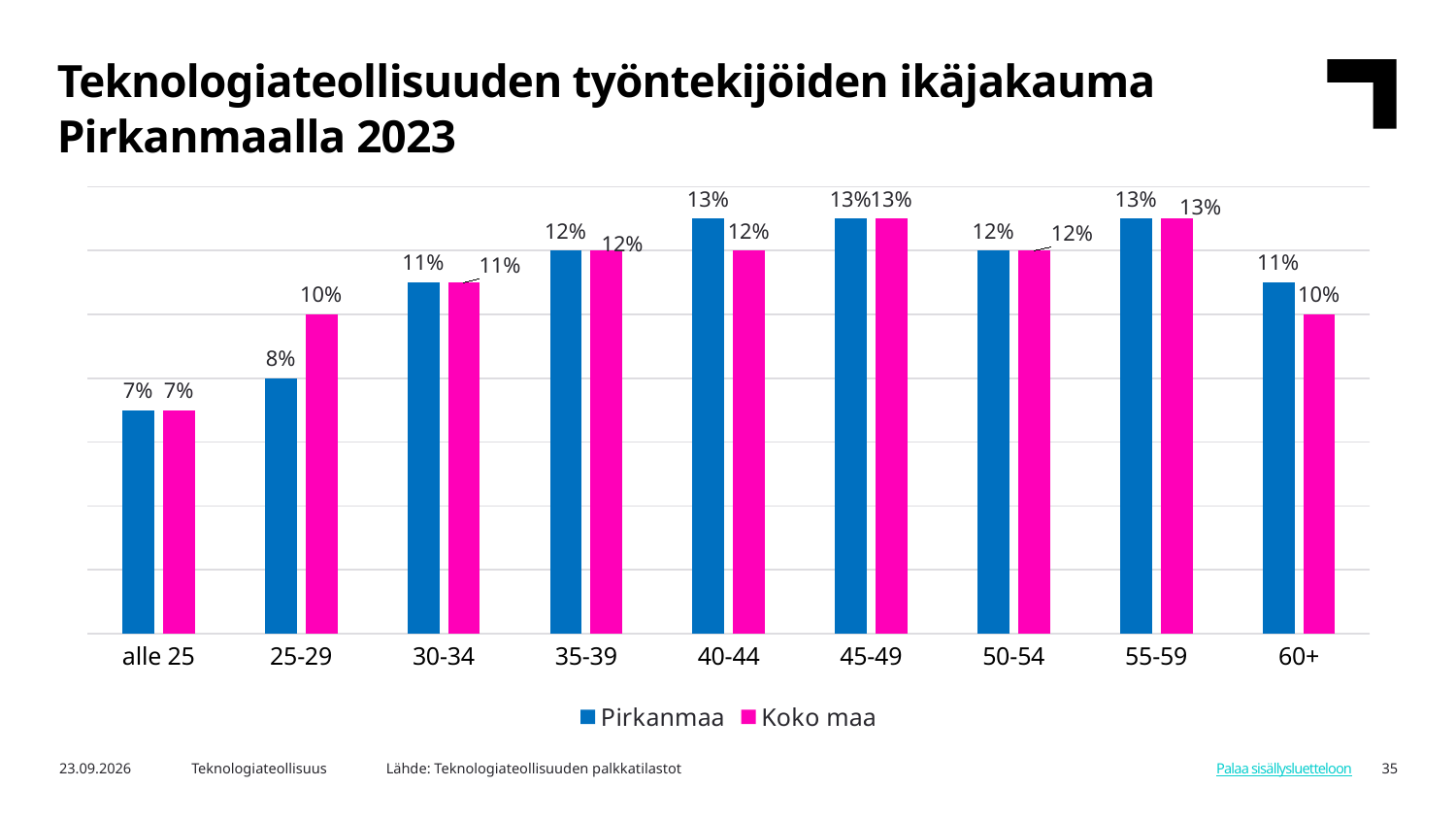
In the 60+ age group, which series has the larger value, Pirkanmaa or Koko maa? Pirkanmaa Which age group has the lowest value for Koko maa? alle 25 How many age groups are shown on the x axis? 9 How many series does the legend list? 2 What is the value for Koko maa in the 25-29 age group? 10% What is the value for Koko maa in the 40-44 age group? 12% What is the value for Pirkanmaa in the 60+ age group? 11% What is the value for Pirkanmaa in the 25-29 age group? 8% What is the difference between the Koko maa and Pirkanmaa values in the 25-29 age group? 2 percentage points In the 25-29 age group, which series has the larger value, Pirkanmaa or Koko maa? Koko maa What kind of chart is shown on the slide? Bar chart Which age group has the lowest value for Pirkanmaa? alle 25